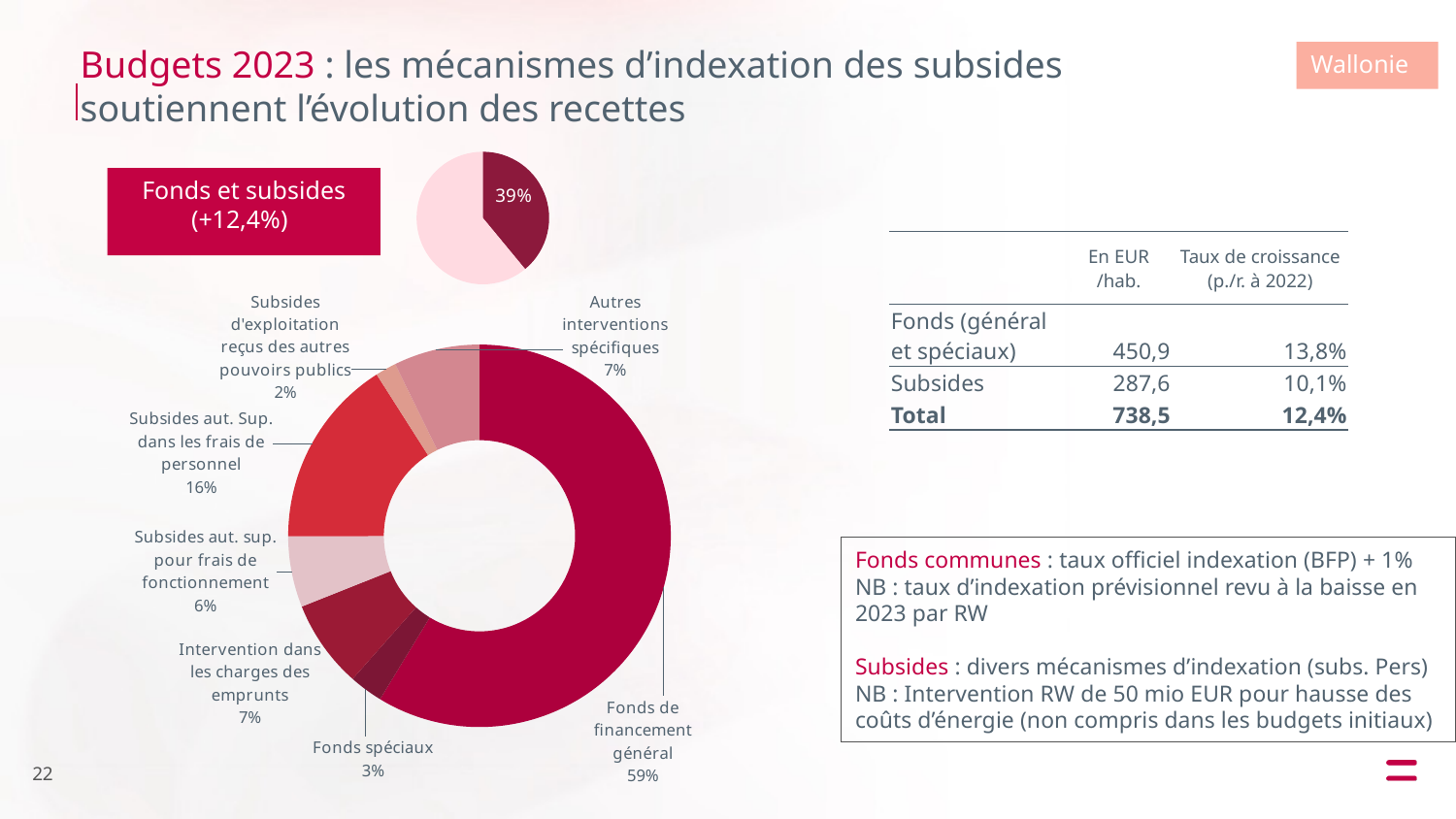
What kind of chart is the large chart on the left of the slide? Donut chart In the large donut chart, what share is shown for Fonds spéciaux? 3% In the large donut chart, which category has the smallest share? Subsides d'exploitation reçus des autres pouvoirs publics In the large donut chart, what is the difference in percentage points between Fonds de financement général and Subsides aut. Sup. dans les frais de personnel? 43 How many categories are shown in the large donut chart? 7 In the large donut chart, what share is shown for Subsides aut. Sup. dans les frais de personnel? 16% In the large donut chart, what share is shown for Subsides aut. sup. pour frais de fonctionnement? 6% In the large donut chart, what share is shown for Fonds de financement général? 59% In the small pie chart at the top, what percentage is printed on the labelled slice? 39% In the large donut chart, which is larger: Intervention dans les charges des emprunts or Fonds spéciaux? Intervention dans les charges des emprunts In the large donut chart, which category has the largest share? Fonds de financement général What text is shown in the red box next to the small pie chart? Fonds et subsides (+12,4%)